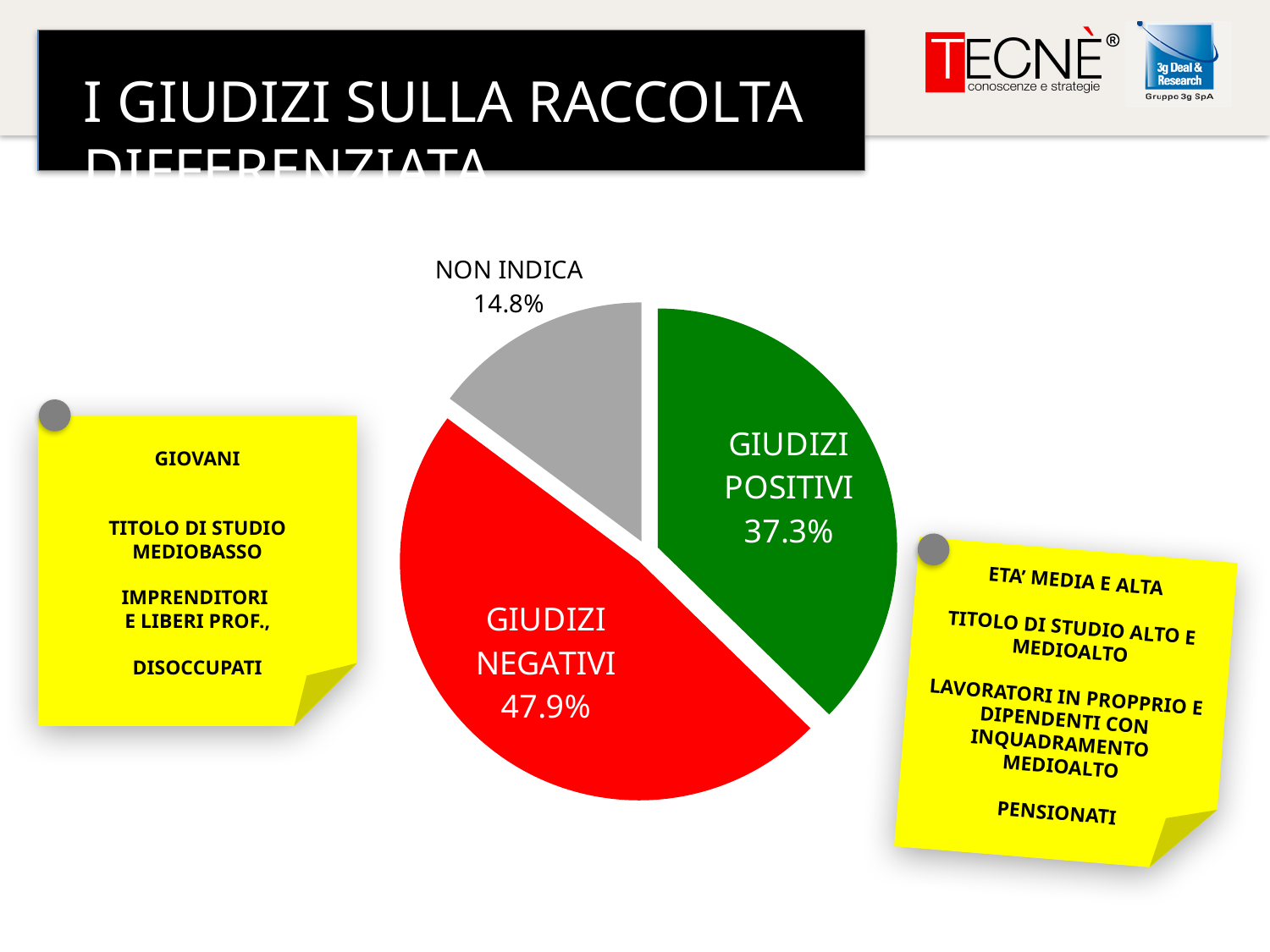
What colour is the NON INDICA slice? grey Which slice of the pie is the smallest? NON INDICA What percentage of the pie is NON INDICA? 14.8% What is the difference in percentage points between GIUDIZI NEGATIVI and GIUDIZI POSITIVI? 10.6 What percentage of the pie is GIUDIZI POSITIVI? 37.3% What is the difference in percentage points between GIUDIZI POSITIVI and NON INDICA? 22.5 What kind of chart is shown on the slide? pie chart What colour is the GIUDIZI NEGATIVI slice? red How many slices does the pie chart have? 3 What percentage of the pie is GIUDIZI NEGATIVI? 47.9% Which is larger, GIUDIZI POSITIVI or NON INDICA? GIUDIZI POSITIVI Which slice of the pie is the largest? GIUDIZI NEGATIVI